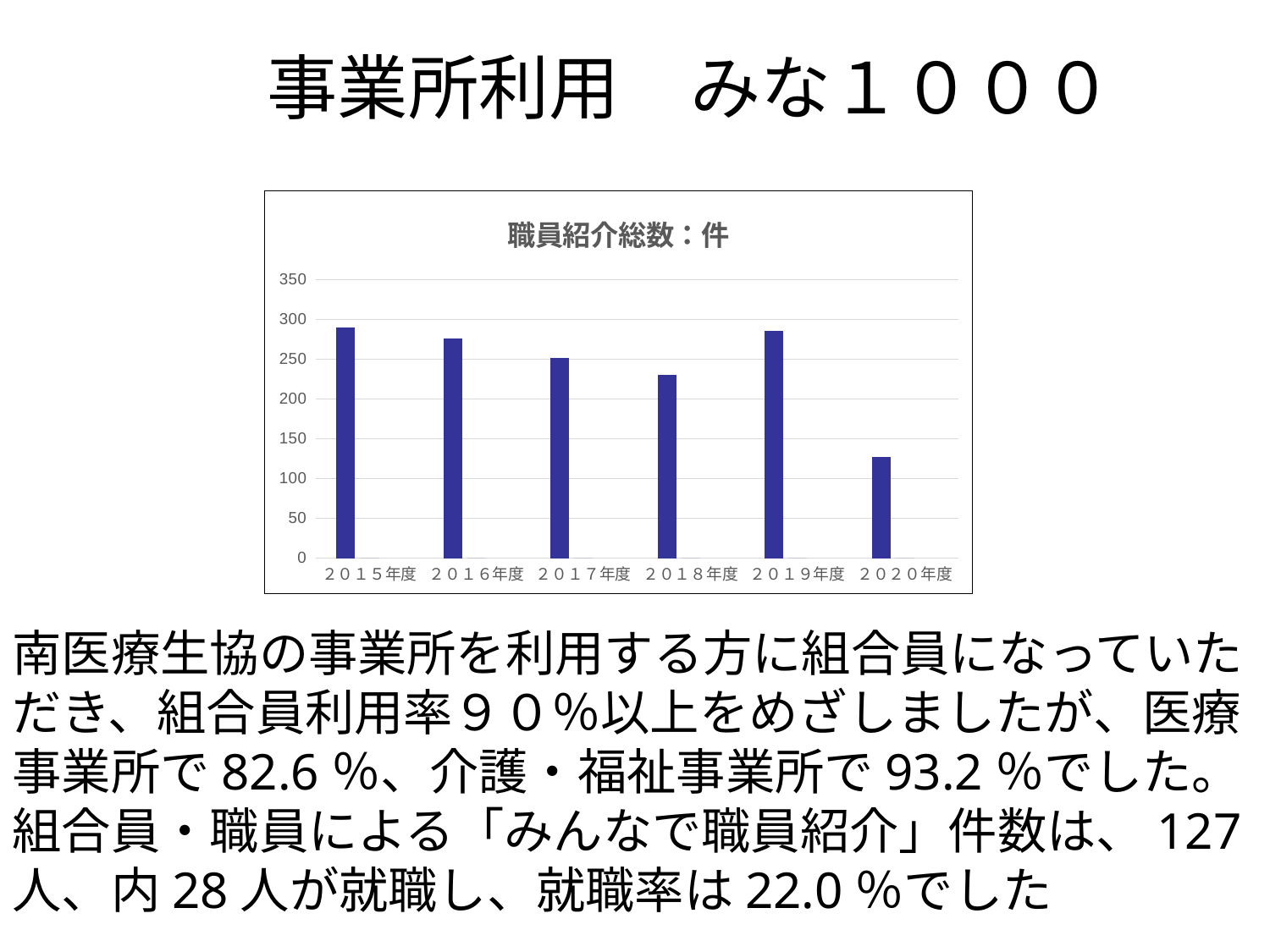
Do the values rise or fall from ２０１５年度 to ２０１８年度? fall Is the value for ２０１９年度 greater or less than 250? greater Is the value for ２０１８年度 greater or less than 250? less Which is larger, the value for ２０１６年度 or ２０１７年度? ２０１６年度 Which fiscal year has the lowest value in the chart? ２０２０年度 What is the title of the chart? 職員紹介総数：件 How many fiscal years are shown on the x axis of the chart? 6 Is the value for ２０２０年度 greater or less than 150? less What colour are the bars in the chart? dark blue What kind of chart is shown on the slide? bar chart Which is larger, the value for ２０１５年度 or ２０１８年度? ２０１５年度